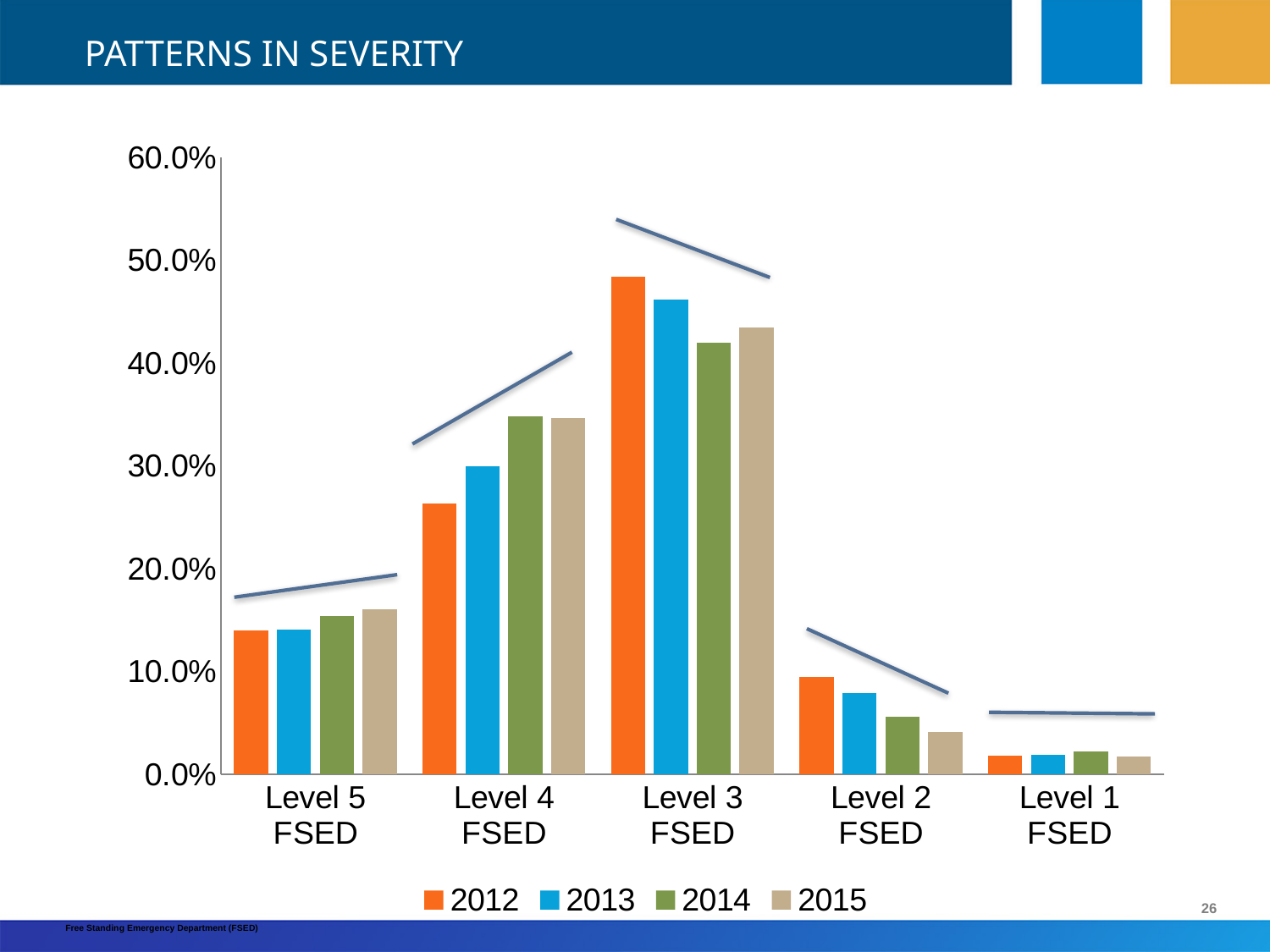
Which category has the highest value for 2012? Level 3 FSED How many severity level categories are shown on the x axis? 5 Which category has the lowest value for 2015? Level 1 FSED Is the 2012 value for Level 3 FSED greater or less than 40.0%? greater What kind of chart is shown on the slide? bar chart For Level 4 FSED, which is larger: the 2012 value or the 2014 value? 2014 What is the title of the slide containing the chart? PATTERNS IN SEVERITY For Level 3 FSED, which is larger: the 2012 value or the 2014 value? 2012 Is the 2015 value for Level 2 FSED greater or less than 10.0%? less For Level 2 FSED, do the values rise or fall from 2012 to 2015? fall How many series does the legend list? 4 Is the 2012 value for Level 4 FSED greater or less than 30.0%? less